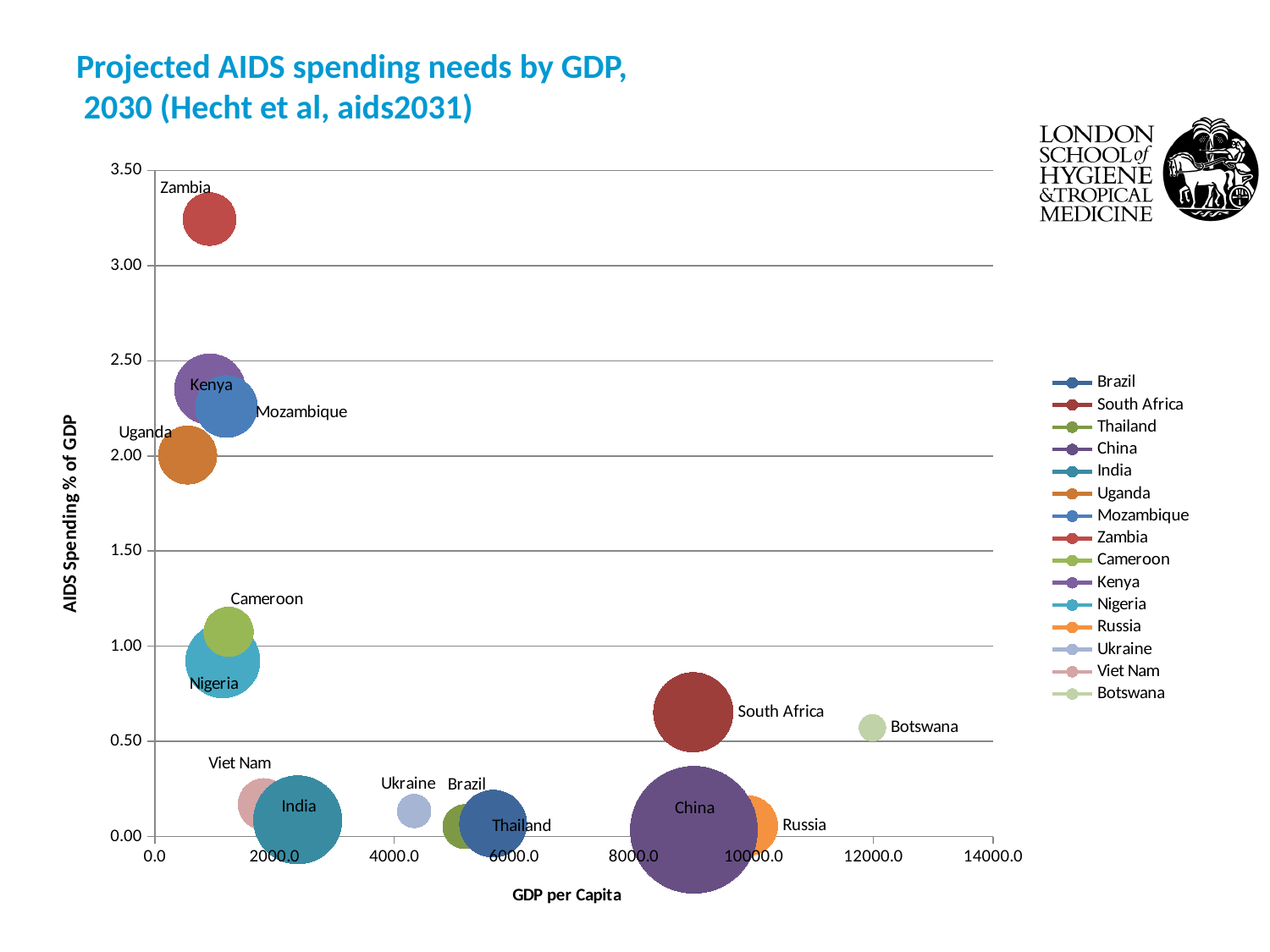
Is the GDP per capita for China greater or less than 8000.0? greater Is the AIDS spending value for Kenya greater or less than 2.00? greater How many series does the legend list? 15 Which country has the highest GDP per capita on the chart? Botswana Is the AIDS spending value for Zambia greater or less than 3.00? greater Which has the higher AIDS spending as a percentage of GDP, Zambia or Kenya? Zambia What kind of chart is shown on the slide? Bubble chart Which country has the highest AIDS spending as a percentage of GDP? Zambia How many countries are plotted on the chart? 15 What is the label of the x axis? GDP per Capita Which country has the lowest GDP per capita on the chart? Uganda